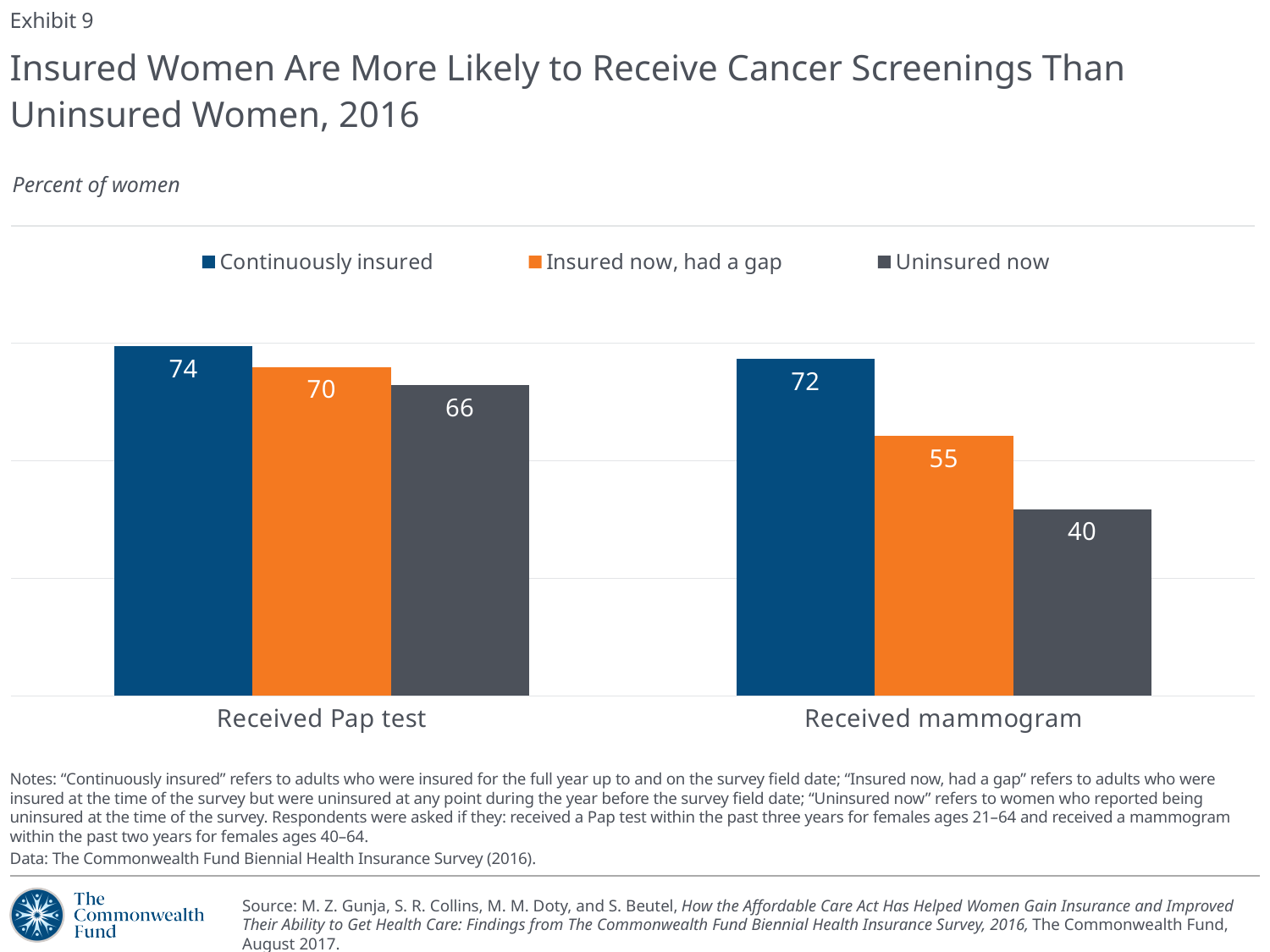
What percent of uninsured now women received a mammogram? 40 What is the difference between continuously insured and insured now, had a gap women for Received Pap test? 4 Which legend entry is shown in orange? Insured now, had a gap Which insurance group has the highest value for Received Pap test? Continuously insured What percent of continuously insured women received a Pap test? 74 Which insurance group has the lowest value for Received mammogram? Uninsured now What is the value for 'Insured now, had a gap' in the Received mammogram category? 55 How many series does the legend list? 3 What is the difference between continuously insured and uninsured now women for Received mammogram? 32 What kind of chart is shown on the slide? Bar chart How many categories are shown on the x axis? 2 Which is larger: the uninsured now value for Received Pap test or for Received mammogram? Received Pap test